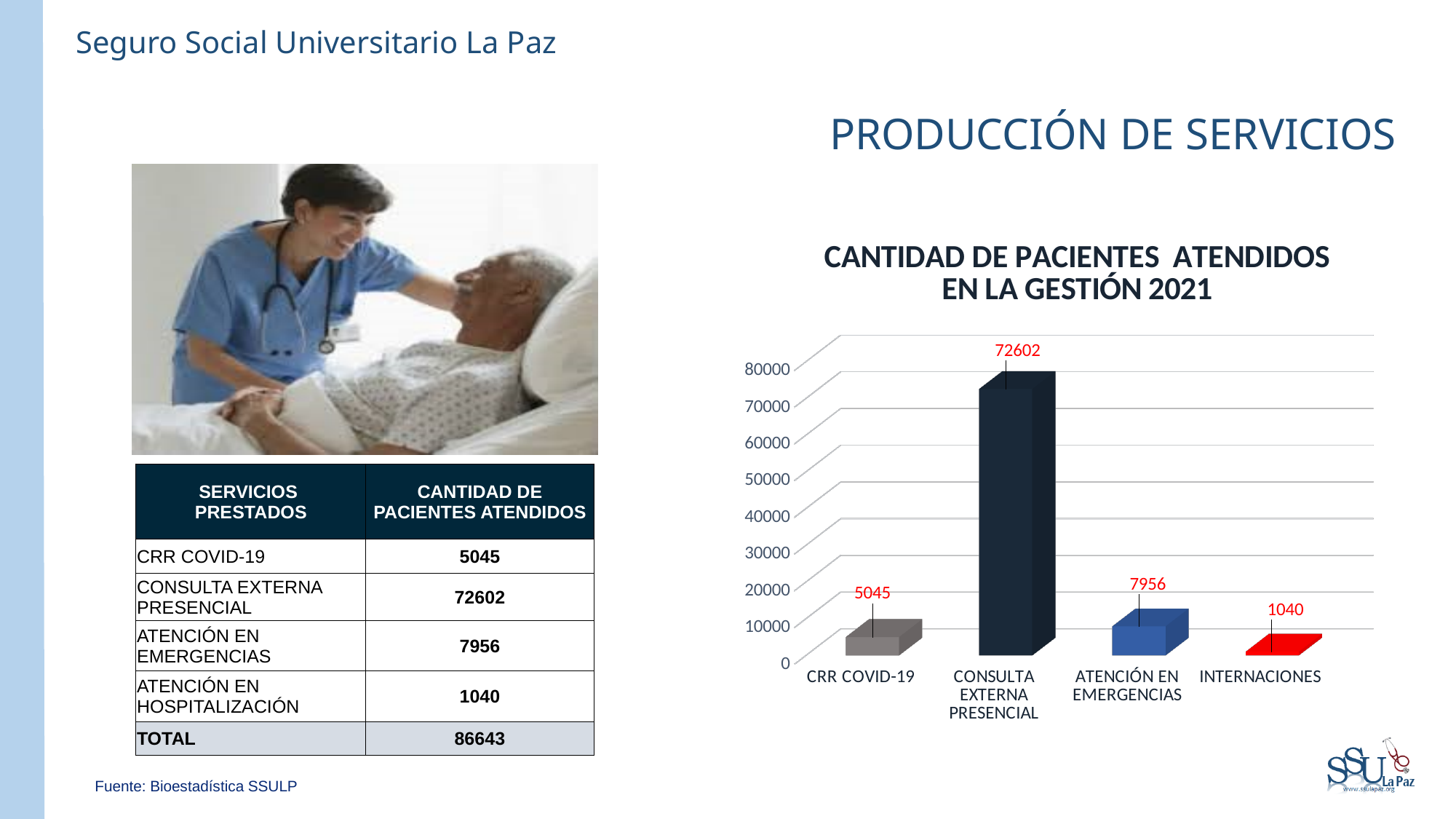
What is the value for CRR COVID-19 in the chart? 5045 Which is larger, the value for CRR COVID-19 or the value for INTERNACIONES? CRR COVID-19 How many categories are shown in the chart? 4 Which category has the highest value in the chart? CONSULTA EXTERNA PRESENCIAL What is the value for CONSULTA EXTERNA PRESENCIAL in the chart? 72602 What kind of chart is shown on the slide? bar chart What is the value for INTERNACIONES in the chart? 1040 Which category has the lowest value in the chart? INTERNACIONES What is the title of the chart? CANTIDAD DE PACIENTES ATENDIDOS EN LA GESTIÓN 2021 What is the value for ATENCIÓN EN EMERGENCIAS in the chart? 7956 Is the value for CONSULTA EXTERNA PRESENCIAL greater or less than 70000? greater What is the difference between the values for ATENCIÓN EN EMERGENCIAS and CRR COVID-19? 2911